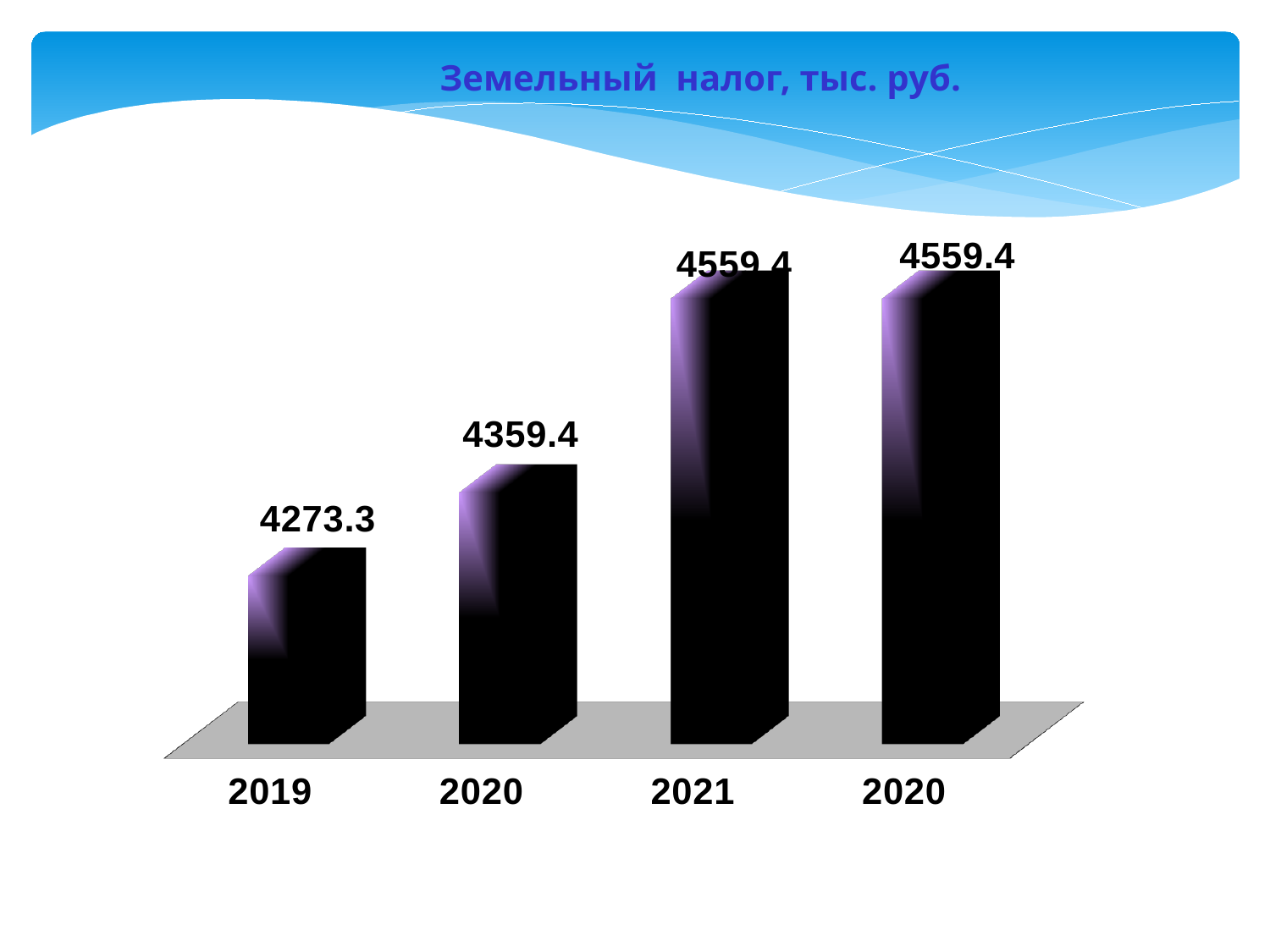
What is the value of the rightmost bar? 4559.4 How many bars are shown in the chart? 4 Which is larger, the value for 2019 or the value for 2021? 2021 What kind of chart is shown on the slide? bar chart What is the title of the chart? Земельный налог, тыс. руб. What is the value for 2021? 4559.4 Do the values rise or fall from the leftmost bar to the third bar? rise What is the difference between the values for 2021 and 2019? 286.1 What is the difference between the second bar from the left and the 2019 bar? 86.1 What is the value of the second bar from the left (the first bar labelled 2020)? 4359.4 Which category has the lowest value? 2019 What is the value for 2019? 4273.3